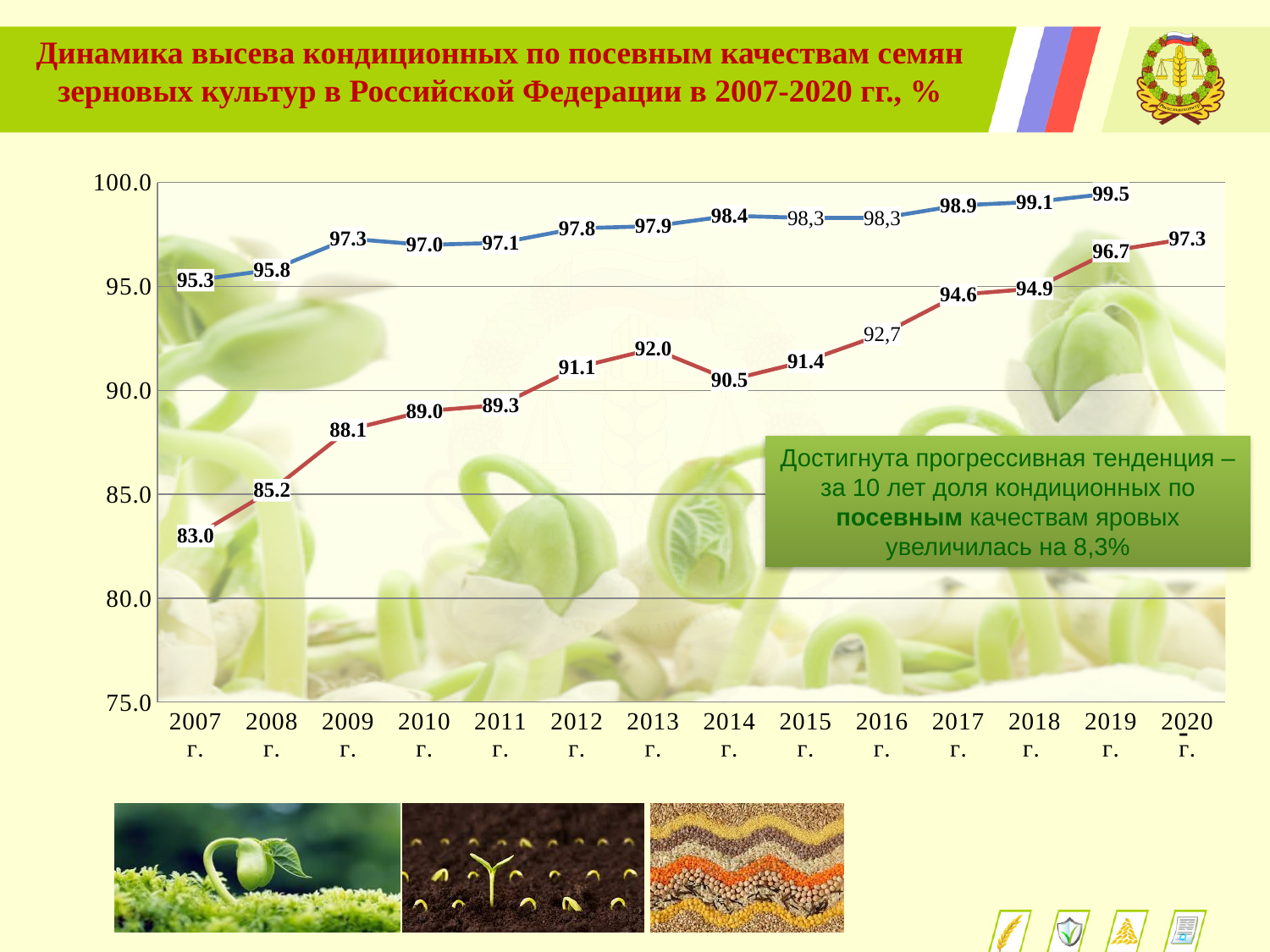
What kind of chart is shown on the slide? line chart How many years are shown on the x axis? 14 In which year does the red line reach its lowest value? 2007 In which year does the red line reach its highest value? 2020 What is the value of the red line for 2020? 97.3 Does the red line generally rise or fall from 2007 to 2020? rise What is the difference between the red line's value in 2020 and its value in 2007? 14.3 Which line has the higher value in 2013, the blue line or the red line? the blue line What is the value of the blue line for 2014? 98.4 What is the value of the red line for 2007? 83.0 What is the value of the blue line for 2007? 95.3 What is the value of the red line for 2016? 92,7